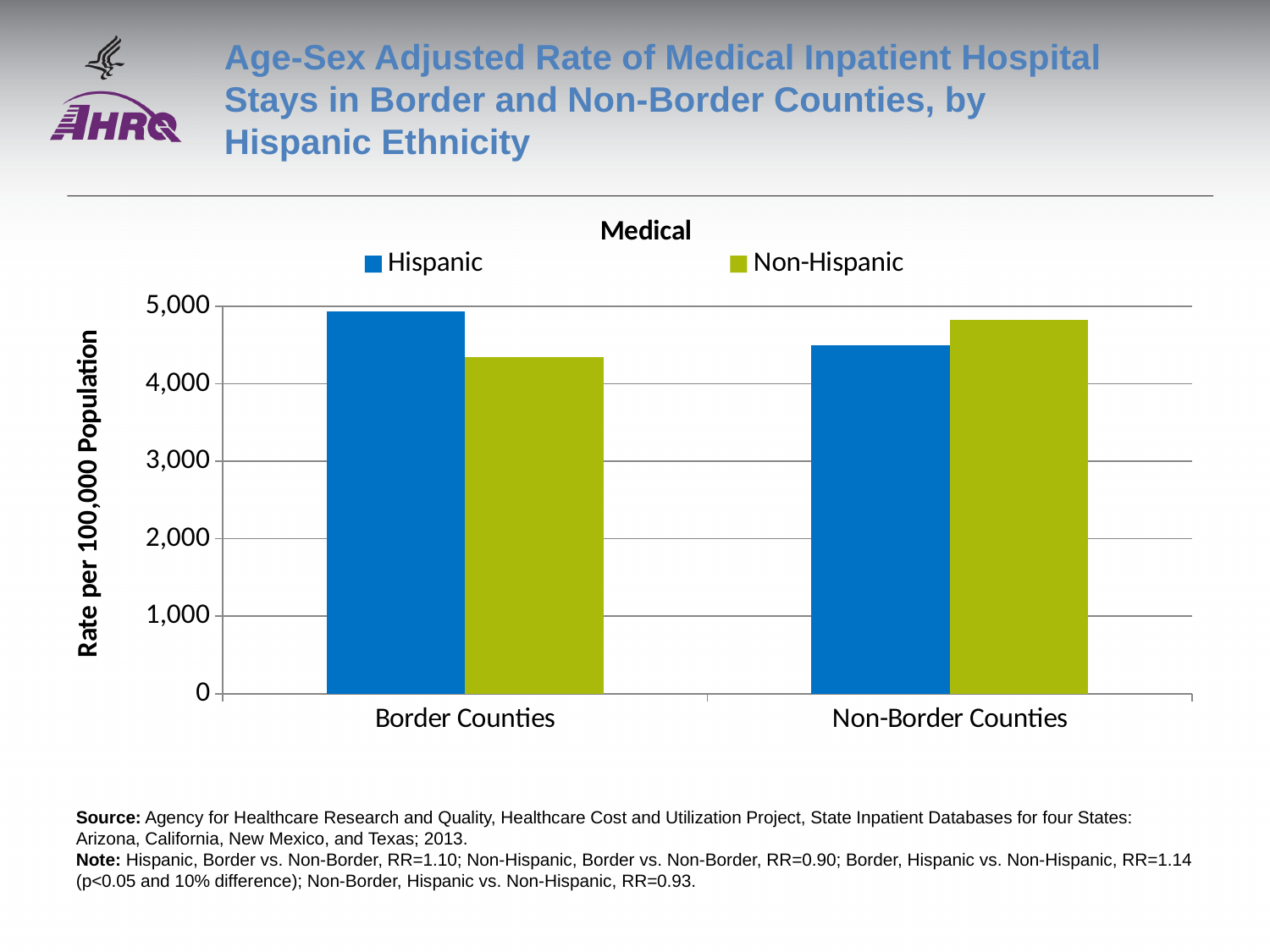
How many county categories are shown on the x axis? 2 Is the value for Hispanic in Border Counties greater or less than 4,000? greater For the Hispanic series, which county category has the higher rate? Border Counties In Border Counties, which is larger, the Hispanic or the Non-Hispanic rate? Hispanic Is the value for Hispanic in Non-Border Counties greater or less than 4,000? greater What is the label on the y axis of the chart? Rate per 100,000 Population How many series does the legend list? 2 Is the value for Non-Hispanic in Border Counties greater or less than 5,000? less In Non-Border Counties, which is larger, the Hispanic or the Non-Hispanic rate? Non-Hispanic For the Non-Hispanic series, which county category has the lower rate? Border Counties What kind of chart is shown on the slide? bar chart